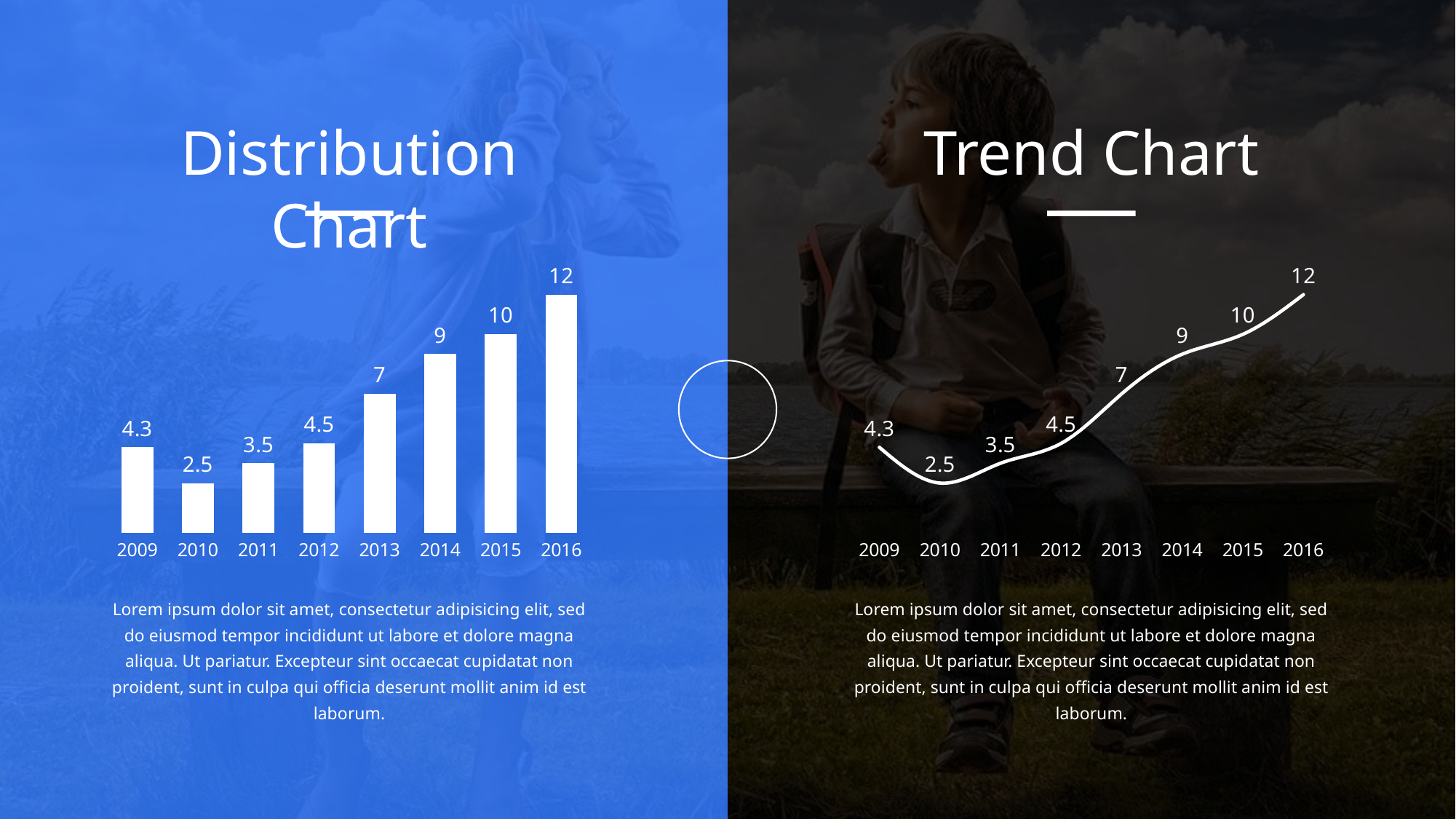
In the Trend Chart, what is the value for 2010? 2.5 What is the title of the chart on the left side of the slide? Distribution Chart In the Distribution Chart, which is larger, the value for 2011 or the value for 2012? 2012 In the Distribution Chart, what is the difference between the values for 2016 and 2009? 7.7 In the Trend Chart, which year has the lowest value? 2010 What kind of chart is the Trend Chart? line chart What kind of chart is the Distribution Chart? bar chart How many years are shown on the x axis of the Trend Chart? 8 In the Trend Chart, what is the difference between the values for 2014 and 2012? 4.5 In the Trend Chart, do the values generally rise or fall from 2010 to 2016? rise In the Distribution Chart, which year has the highest value? 2016 In the Distribution Chart, what is the value for 2013? 7